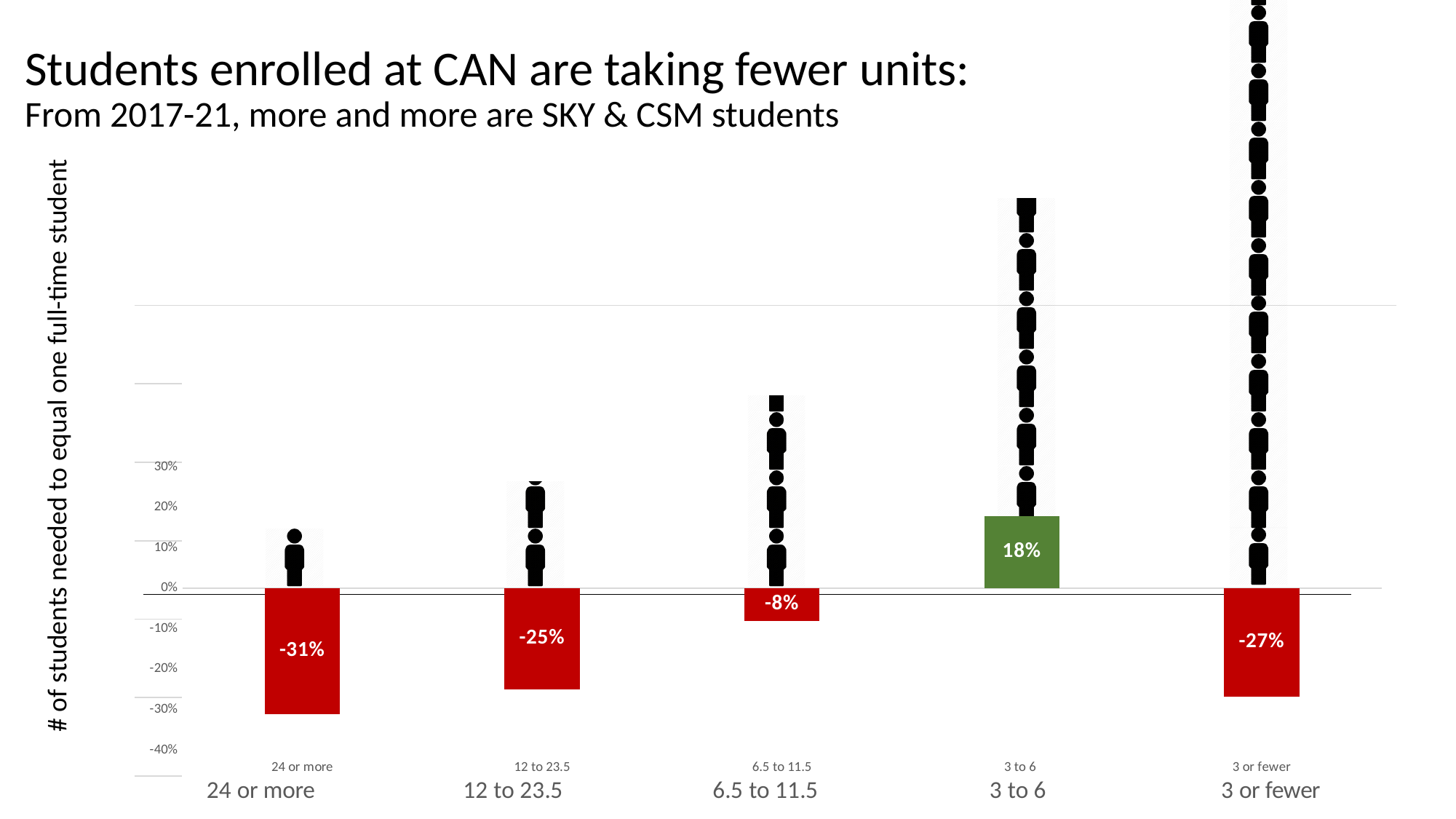
What is the value for the "24 or more" category? -31% Is the value for "24 or more" greater or less than -30%? less What is the value for the "6.5 to 11.5" category? -8% What kind of chart is shown on the slide? bar chart Which is larger, the value for "12 to 23.5" or the value for "3 or fewer"? 12 to 23.5 Which category has the lowest value? 24 or more Which category is the only one shown with a green bar? 3 to 6 What is the value for the "3 or fewer" category? -27% What is the difference between the values for "12 to 23.5" and "6.5 to 11.5"? 17 percentage points What is the value for the "3 to 6" category? 18% Which category has the highest value? 3 to 6 How many categories are shown on the x axis? 5